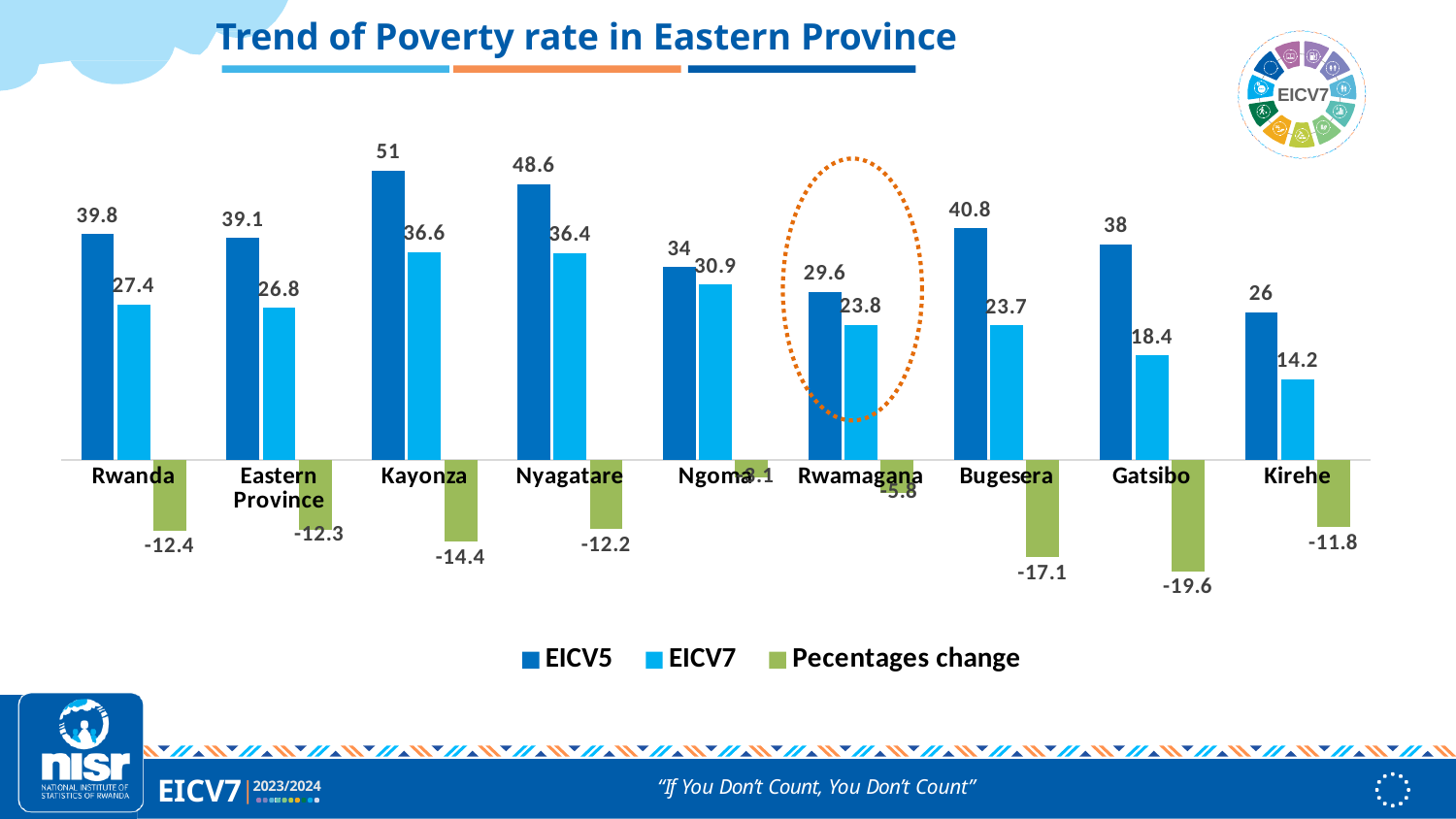
Which is larger, the EICV7 poverty rate for Nyagatare or for Gatsibo? Nyagatare What is the EICV5 poverty rate for Kayonza? 51 What is the EICV7 poverty rate for Bugesera? 23.7 What is the percentage change shown for Gatsibo? -19.6 Which category is highlighted with an orange dotted circle? Rwamagana How many series does the legend list? 3 Which category has the lowest EICV7 poverty rate? Kirehe What is the difference between the EICV5 and EICV7 poverty rates for Bugesera? 17.1 Which category has the highest EICV5 poverty rate? Kayonza What kind of chart is shown on the slide? Bar chart What is the EICV7 poverty rate for Eastern Province? 26.8 How many categories are shown on the x axis? 9